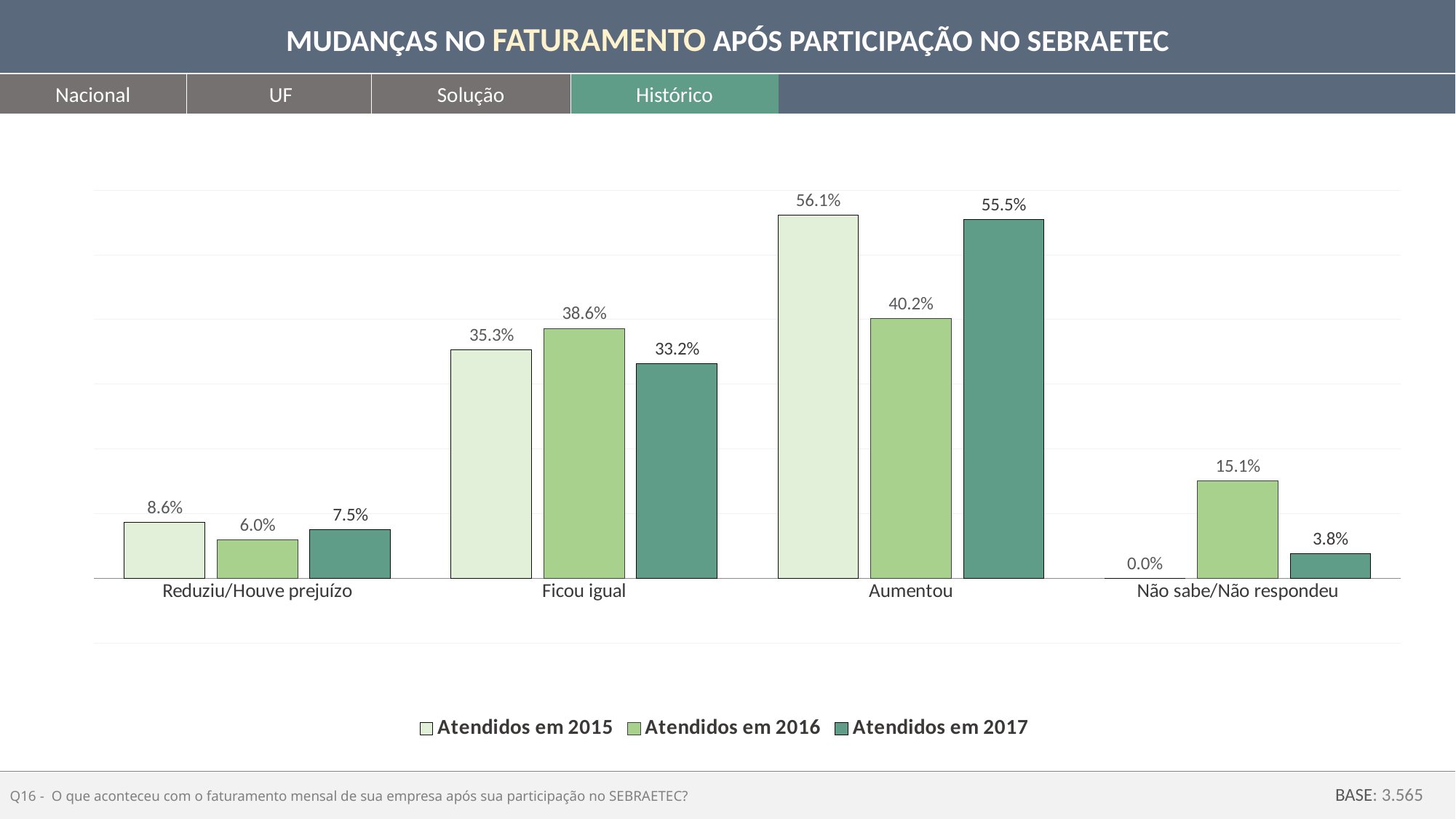
What is the value for 'Ficou igual' in the 'Atendidos em 2016' series? 38.6% What is the value for 'Não sabe/Não respondeu' in the 'Atendidos em 2017' series? 3.8% Which category has the highest value in the 'Atendidos em 2017' series? Aumentou What is the base (sample size) shown at the bottom of the slide? 3.565 What kind of chart is shown on the slide? Bar chart What is the value for 'Reduziu/Houve prejuízo' in the 'Atendidos em 2016' series? 6.0% Which is larger for 'Ficou igual': the 'Atendidos em 2016' value or the 'Atendidos em 2017' value? Atendidos em 2016 What is the difference between the 'Atendidos em 2015' and 'Atendidos em 2016' values for 'Aumentou'? 15.9% How many series does the legend list? 3 How many categories are shown on the x axis? 4 Which category has the lowest value in the 'Atendidos em 2015' series? Não sabe/Não respondeu What is the value for 'Aumentou' in the 'Atendidos em 2015' series? 56.1%